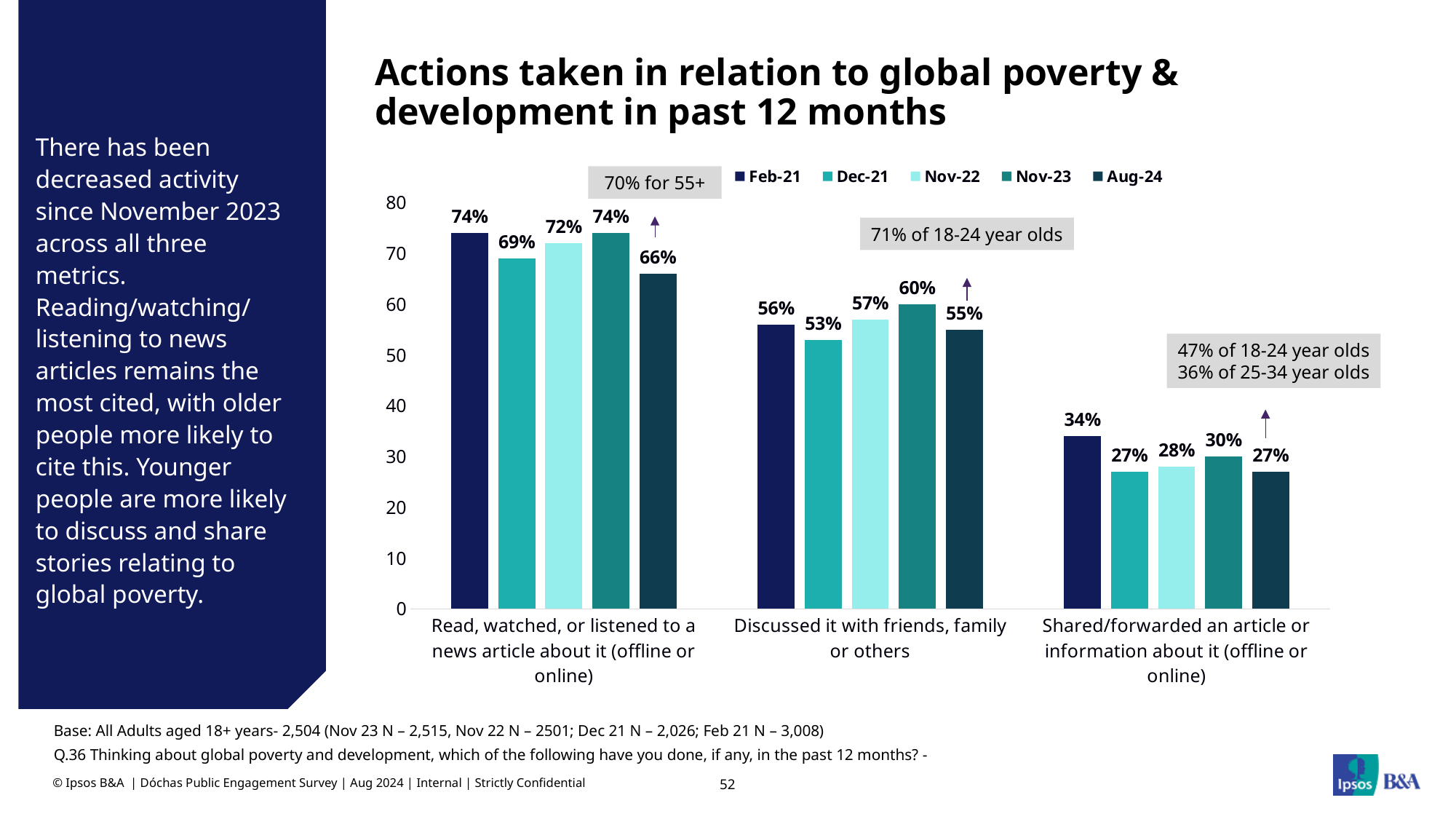
Which category has the lowest Aug-24 value? Shared/forwarded an article or information about it (offline or online) What is the title of the chart? Actions taken in relation to global poverty & development in past 12 months Which is larger for 'Discussed it with friends, family or others': the Feb-21 value or the Dec-21 value? Feb-21 How many categories are shown on the x axis? 3 What is the difference between the Nov-23 and Aug-24 values for 'Read, watched, or listened to a news article about it (offline or online)'? 8% What is the Feb-21 value for 'Shared/forwarded an article or information about it (offline or online)'? 34% What is the Nov-23 value for 'Discussed it with friends, family or others'? 60% Did the value for 'Shared/forwarded an article or information about it (offline or online)' rise or fall from Nov-23 to Aug-24? Fall What kind of chart is shown on the slide? Bar chart How many series does the legend list? 5 What is the Aug-24 value for 'Read, watched, or listened to a news article about it (offline or online)'? 66% Which category has the highest Nov-22 value? Read, watched, or listened to a news article about it (offline or online)